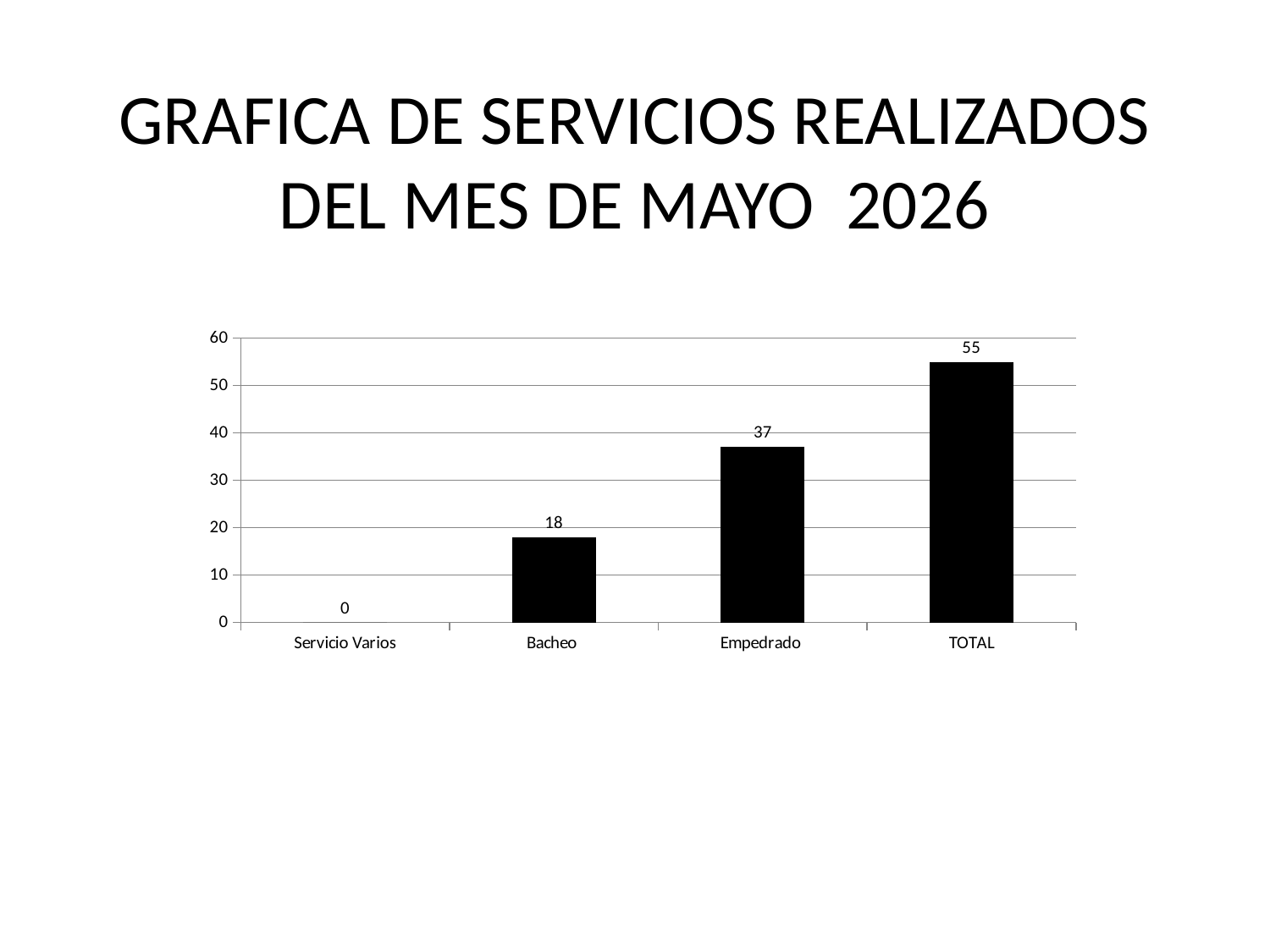
What kind of chart is shown on the slide? bar chart Which category has the lowest value? Servicio Varios What is the value for Bacheo? 18 What is the value for TOTAL? 55 What is the difference between the values for Empedrado and Bacheo? 19 Which category has the highest value? TOTAL What is the value for Servicio Varios? 0 What is the title of the slide? GRAFICA DE SERVICIOS REALIZADOS DEL MES DE MAYO 2026 How many categories are shown on the x axis? 4 Is the value for Empedrado greater or less than 30? greater What is the value for Empedrado? 37 Which is larger, the value for Bacheo or the value for Empedrado? Empedrado